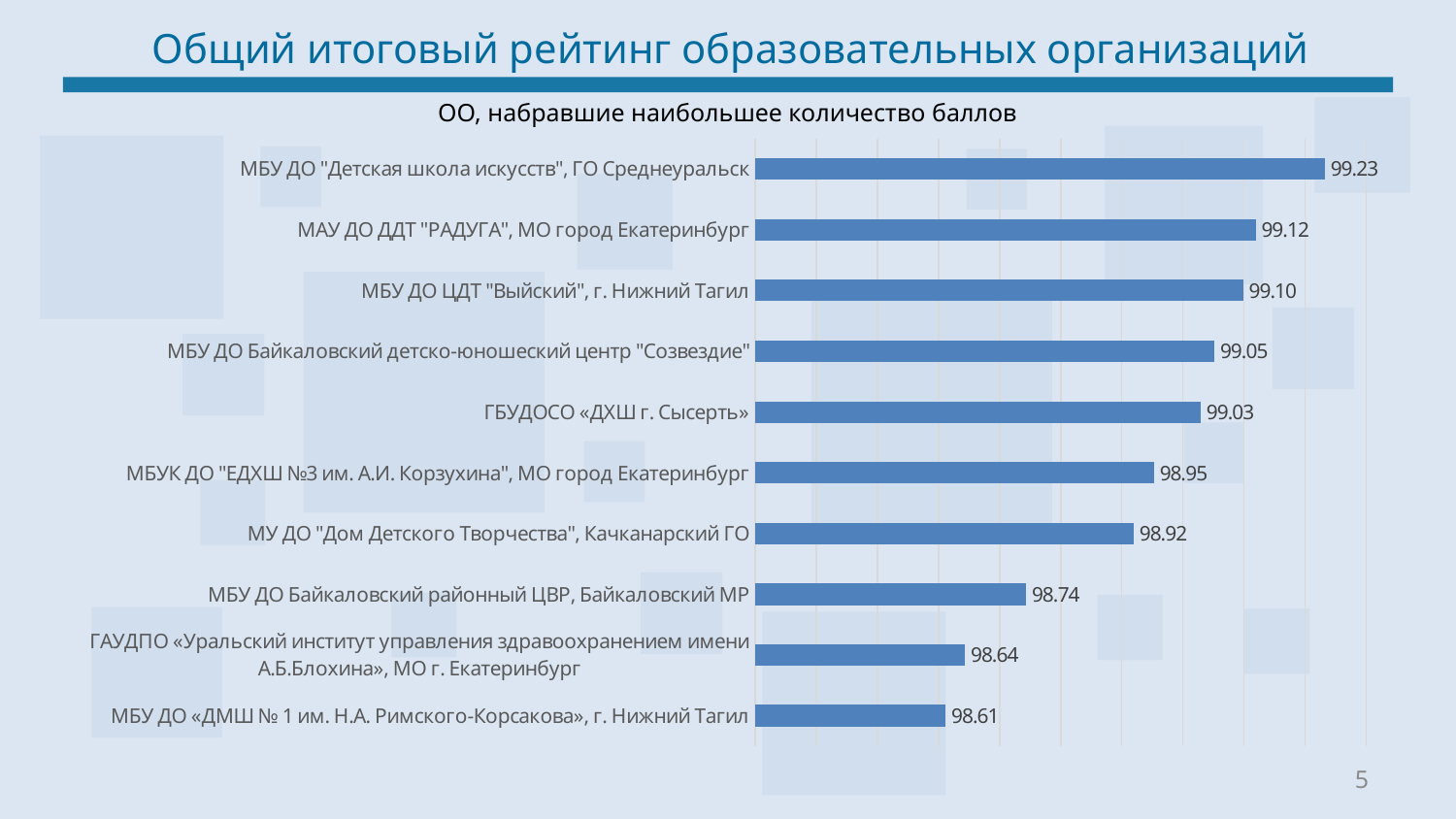
Which organisation has the highest value in the chart? МБУ ДО "Детская школа искусств", ГО Среднеуральск What is the difference between the values for МБУ ДО "Детская школа искусств", ГО Среднеуральск and МБУ ДО «ДМШ № 1 им. Н.А. Римского-Корсакова», г. Нижний Тагил? 0.62 What is the value for ГБУДОСО «ДХШ г. Сысерть»? 99.03 How many organisations are shown in the chart? 10 Which has a larger value: МБУК ДО "ЕДХШ №3 им. А.И. Корзухина", МО город Екатеринбург or ГАУДПО «Уральский институт управления здравоохранением имени А.Б.Блохина», МО г. Екатеринбург? МБУК ДО "ЕДХШ №3 им. А.И. Корзухина", МО город Екатеринбург What is the value for МУ ДО "Дом Детского Творчества", Качканарский ГО? 98.92 What is the value for МБУ ДО "Детская школа искусств", ГО Среднеуральск? 99.23 What is the difference between the values for МАУ ДО ДДТ "РАДУГА", МО город Екатеринбург and МБУ ДО Байкаловский районный ЦВР, Байкаловский МР? 0.38 Which organisation has the lowest value in the chart? МБУ ДО «ДМШ № 1 им. Н.А. Римского-Корсакова», г. Нижний Тагил What is the title of the chart? ОО, набравшие наибольшее количество баллов What is the value for МБУ ДО «ДМШ № 1 им. Н.А. Римского-Корсакова», г. Нижний Тагил? 98.61 What type of chart is shown on the slide? Bar chart